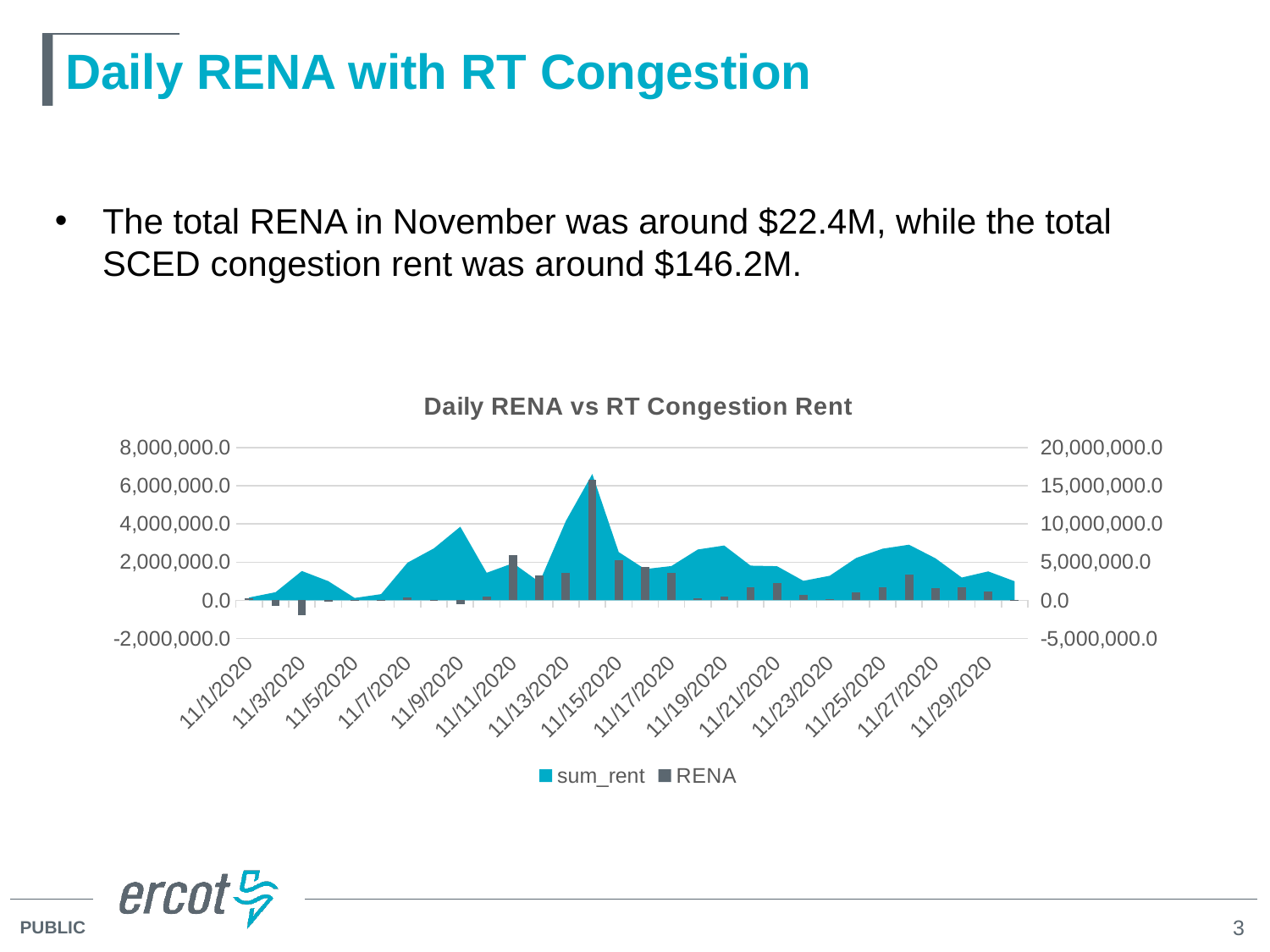
Does the sum_rent series rise or fall between 11/5/2020 and 11/9/2020? rise What is the title of the chart on the slide? Daily RENA vs RT Congestion Rent What is the last date label on the x axis of the chart? 11/29/2020 How many series does the legend of the 'Daily RENA vs RT Congestion Rent' chart list? 2 What is the first date label on the x axis of the chart? 11/1/2020 Which series in the chart is drawn as bars? RENA What kind of chart is shown on the slide? A combination chart with an area series and a bar series On which date does the RENA series reach its highest bar? 11/14/2020 On which date does the sum_rent area reach its highest peak? 11/14/2020